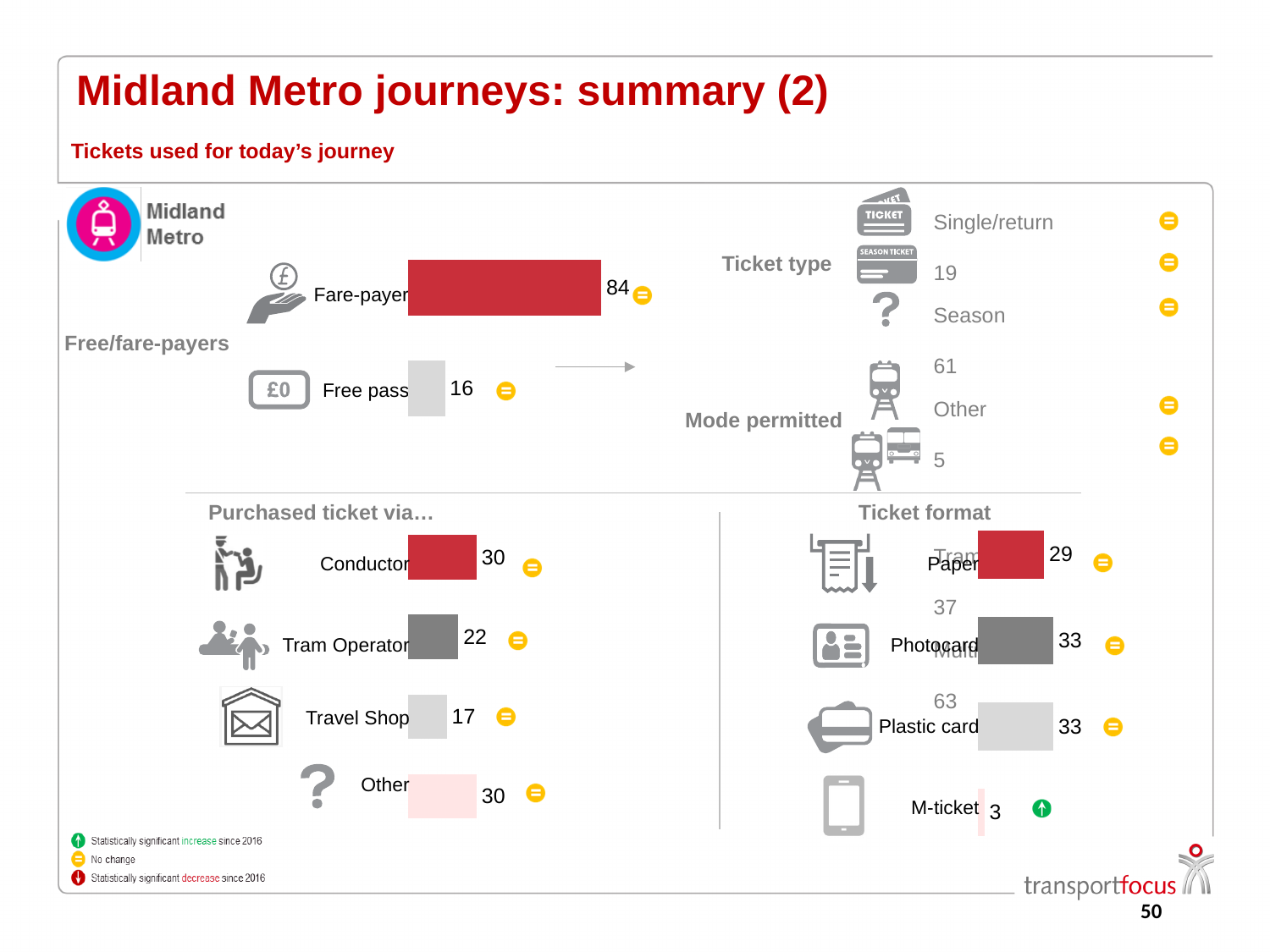
In the Free/fare-payers chart, what is the difference between Fare-payer and Free pass? 68 In the Ticket format chart, which category shows a statistically significant increase since 2016? M-ticket In the Purchased ticket via… chart, which category has the lowest value? Travel Shop In the Ticket format chart, which is larger, Photocard or Paper? Photocard In the Purchased ticket via… chart, how many categories are shown? 4 What kind of chart is the Purchased ticket via… chart? Bar chart In the Purchased ticket via… chart, what is the value for Travel Shop? 17 In the Ticket format chart, what is the value for Paper? 29 In the Free/fare-payers chart, what is the value for Fare-payer? 84 In the Ticket format chart, what is the value for M-ticket? 3 In the Purchased ticket via… chart, what is the value for Tram Operator? 22 In the Free/fare-payers chart, what is the value for Free pass? 16